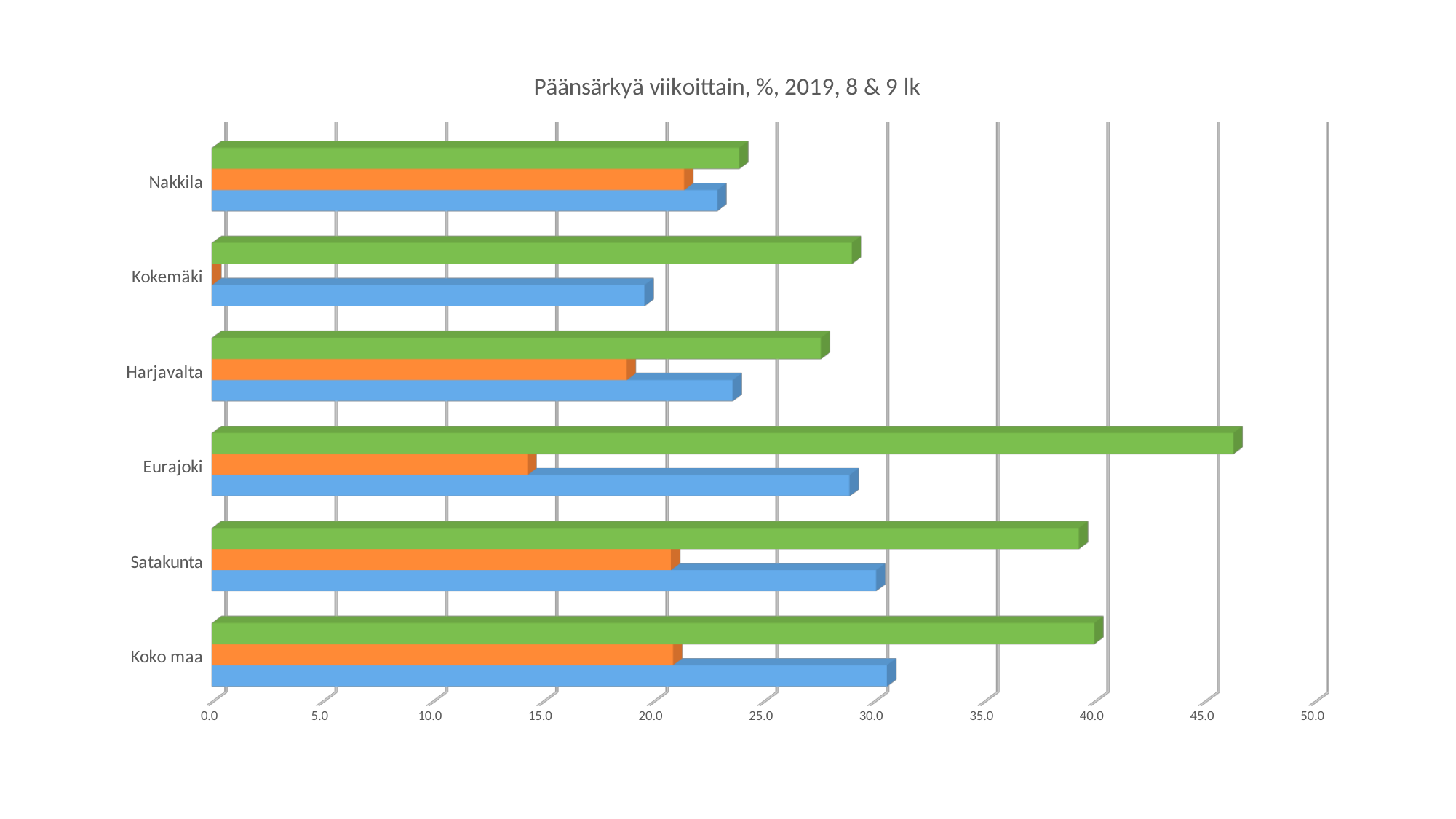
Which is larger, the green bar for Eurajoki or the green bar for Satakunta? Eurajoki What kind of chart is shown on the slide? bar chart Is the orange bar for Eurajoki greater or less than 20.0? less What is the title of the chart? Päänsärkyä viikoittain, %, 2019, 8 & 9 lk Which is larger, the blue bar for Nakkila or the blue bar for Kokemäki? Nakkila Is the green bar for Eurajoki greater or less than 45.0? greater Which category has the longest green bar? Eurajoki How many bars are plotted for each category in the chart? 3 Which category has the shortest orange bar? Kokemäki Is the orange bar for Kokemäki greater or less than 5.0? less How many categories are shown on the vertical axis of the chart? 6